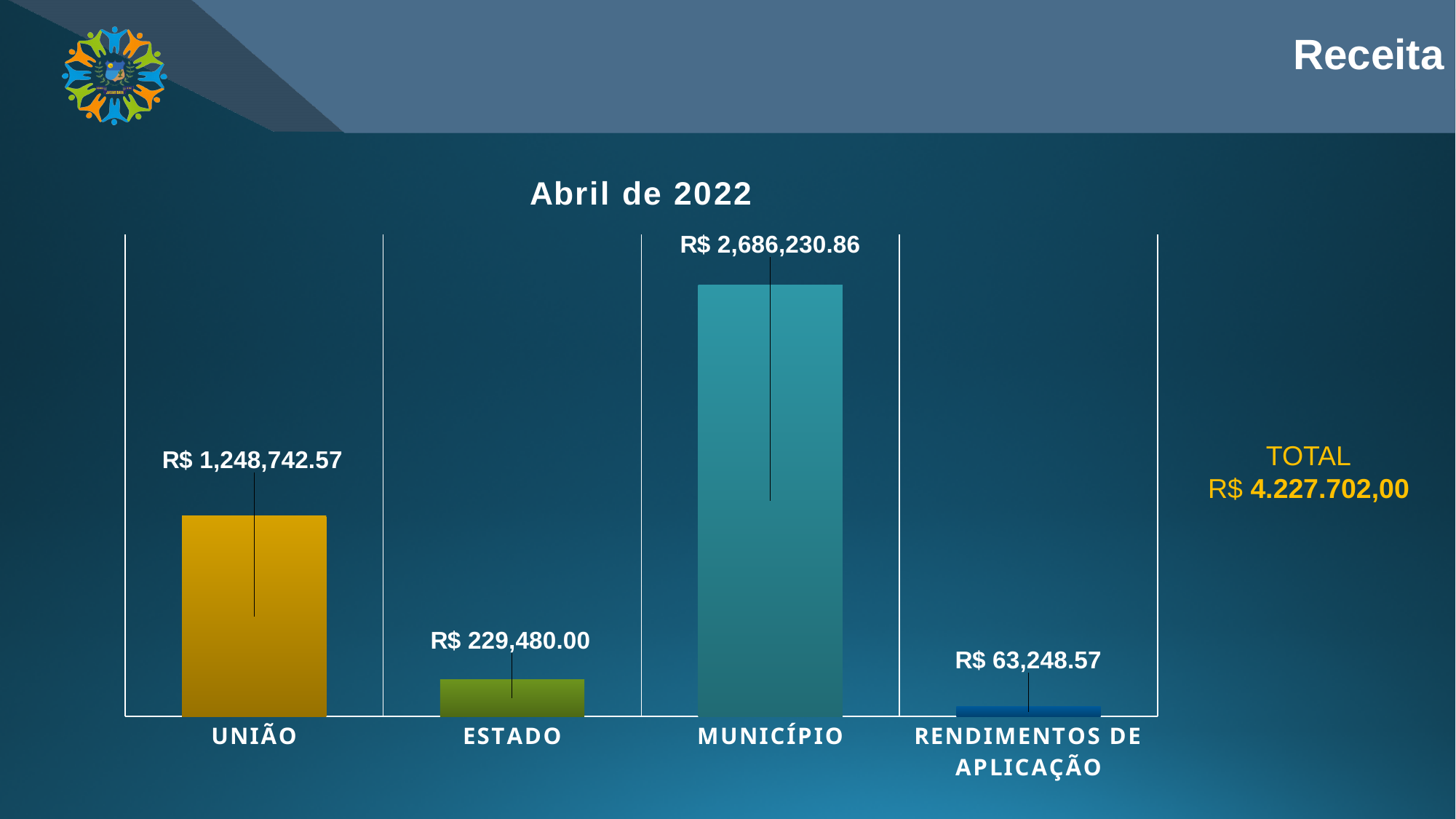
What kind of chart is shown on the slide? Bar chart What is the difference between the values for UNIÃO and ESTADO? R$ 1,019,262.57 What is the title of the chart? Abril de 2022 Which is larger, the value for ESTADO or the value for RENDIMENTOS DE APLICAÇÃO? ESTADO What is the difference between the values for MUNICÍPIO and UNIÃO? R$ 1,437,488.29 How many categories are shown in the chart? 4 Which category has the lowest value? RENDIMENTOS DE APLICAÇÃO What is the value for ESTADO? R$ 229,480.00 Which category has the highest value? MUNICÍPIO What is the value for RENDIMENTOS DE APLICAÇÃO? R$ 63,248.57 What is the value for UNIÃO? R$ 1,248,742.57 What is the value for MUNICÍPIO? R$ 2,686,230.86